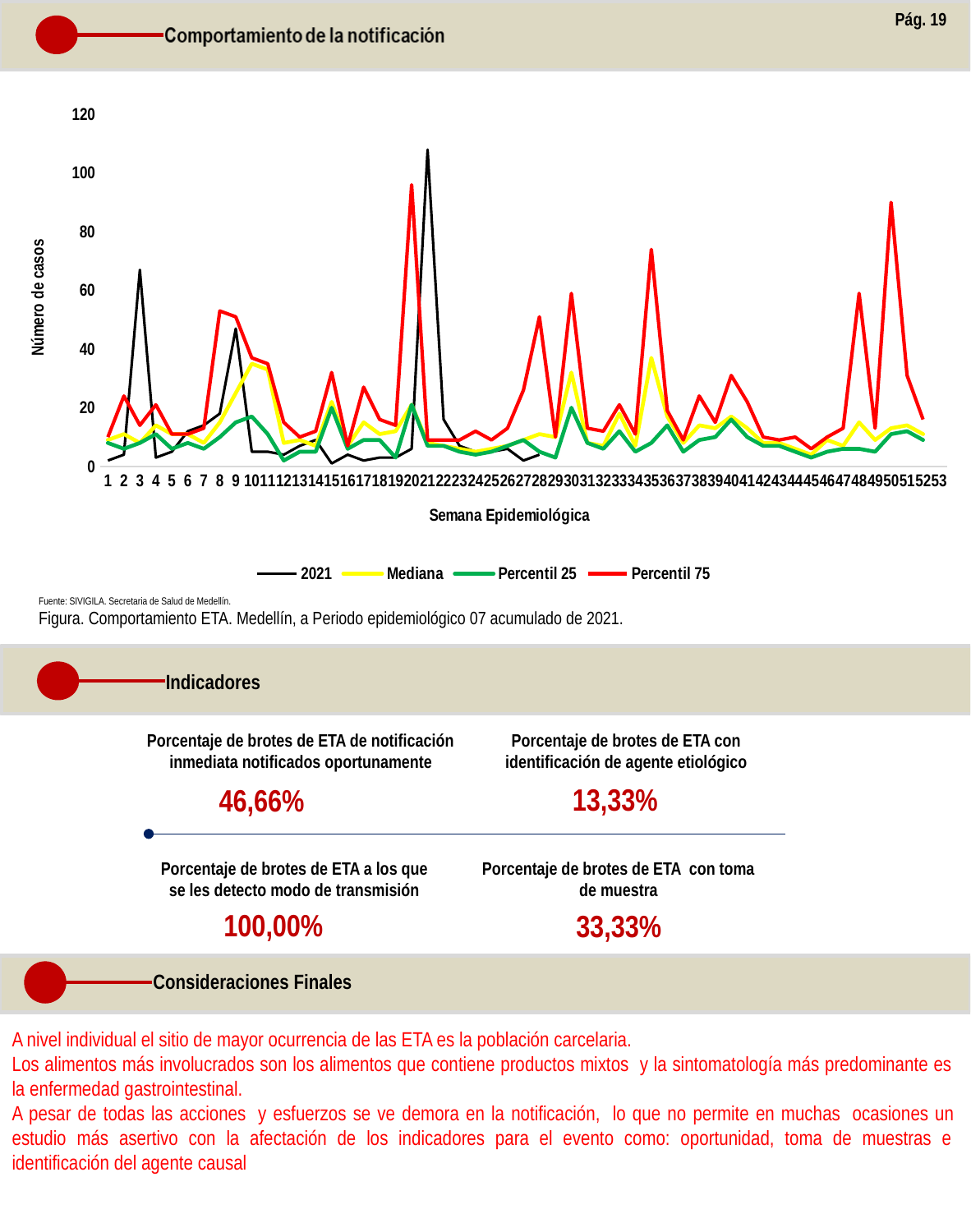
Is the value of the 2021 series in week 3 greater or less than 60? greater Which is larger for the 2021 series: the value in week 21 or the value in week 3? Week 21 How many epidemiological weeks are shown on the x axis of the chart? 53 What kind of chart is shown on the slide? Line chart In which epidemiological week does the 2021 series reach its highest value? 21 What is the title of the x axis of the chart? Semana Epidemiológica How many series does the chart legend list? 4 Is the value of the Percentil 25 series in week 20 greater or less than 40? less In week 20, which series has the larger value: Percentil 75 or Percentil 25? Percentil 75 Is the value of the Percentil 75 series in week 50 greater or less than 80? greater Which colour is used for the Percentil 75 series in the chart? Red